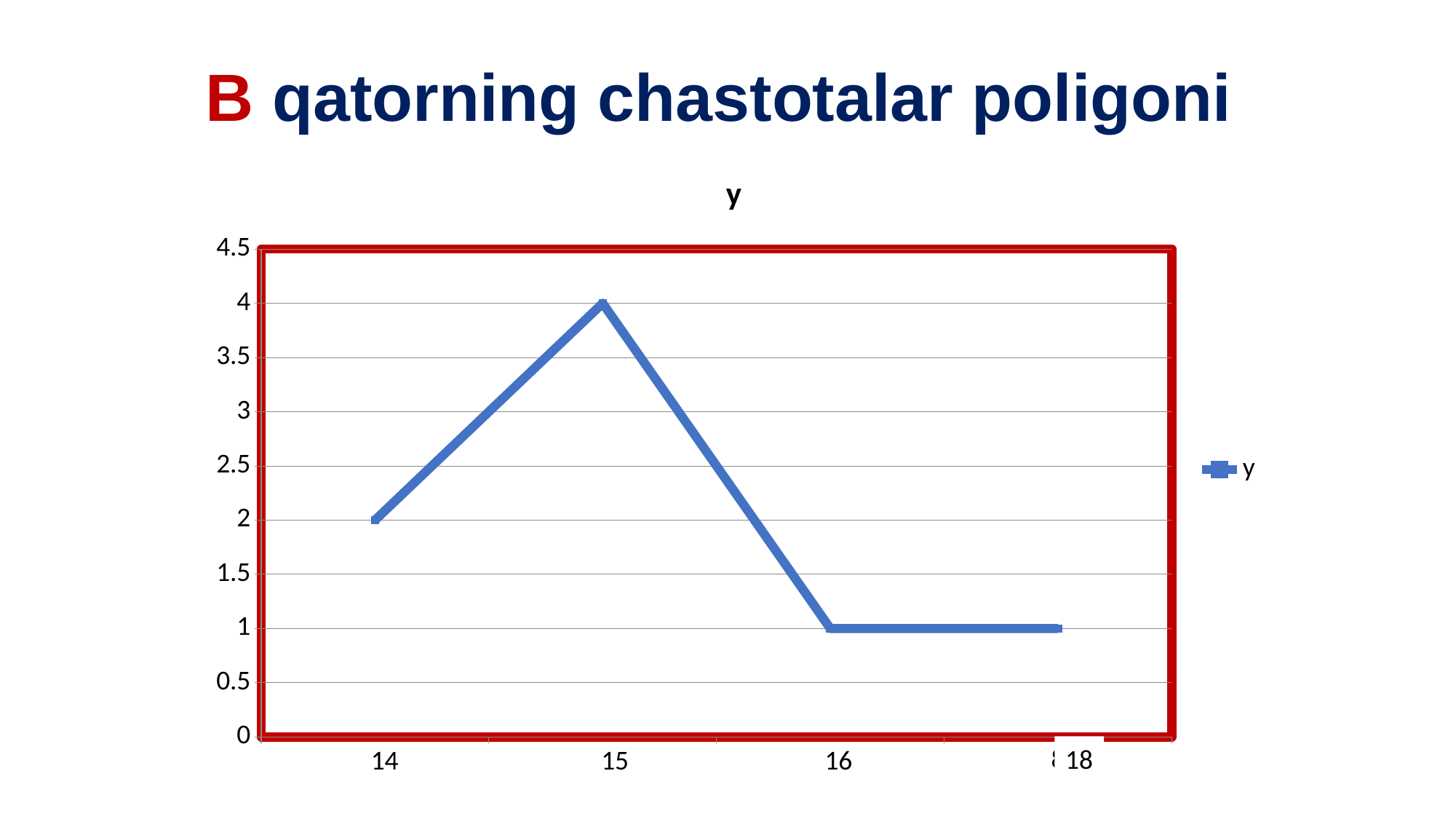
What kind of chart is shown on the slide? line chart Does the line rise or fall from 15 to 16? fall How many data points are plotted on the line? 4 Which has the larger y value, 14 or 16? 14 What is the title of the chart? y What is the value of y at 14? 2 What is the value of y at 16? 1 At which x value is y highest? 15 Is the value of y at 14 greater or less than 3? less What is the value of y at 15? 4 What is the difference between the y value at 15 and the y value at 14? 2 How many series does the legend list? 1